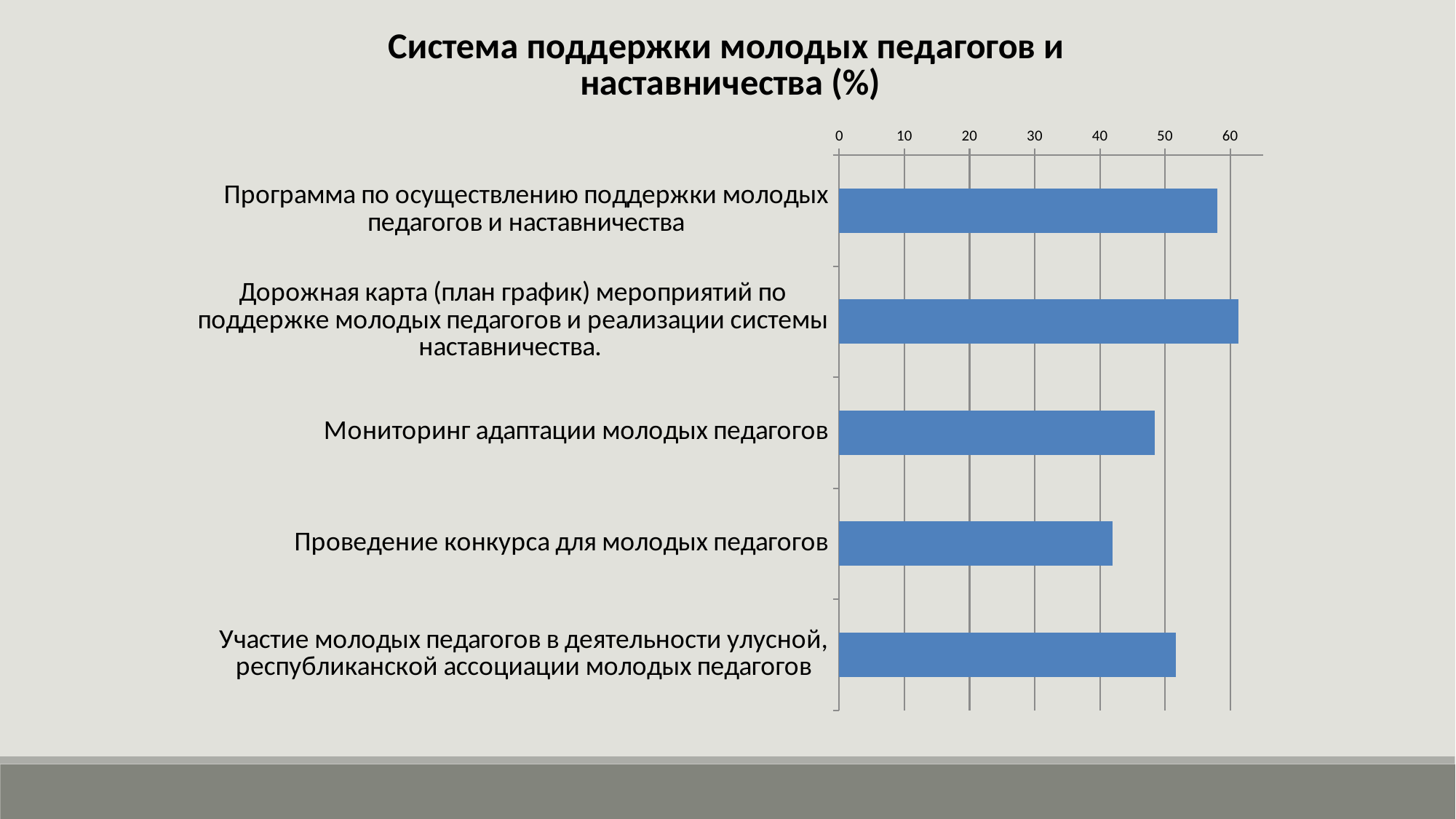
Is the value for "Программа по осуществлению поддержки молодых педагогов и наставничества" greater or less than 50? greater Is the value for "Мониторинг адаптации молодых педагогов" greater or less than 40? greater Is the value for "Проведение конкурса для молодых педагогов" greater or less than 50? less What kind of chart is shown on the slide? Bar chart What is the title of the chart? Система поддержки молодых педагогов и наставничества (%) Which category has the highest value in the chart? Дорожная карта (план график) мероприятий по поддержке молодых педагогов и реализации системы наставничества. Which category has the lowest value in the chart? Проведение конкурса для молодых педагогов Which is larger: the value for "Проведение конкурса для молодых педагогов" or for "Участие молодых педагогов в деятельности улусной, республиканской ассоциации молодых педагогов"? Участие молодых педагогов в деятельности улусной, республиканской ассоциации молодых педагогов How many categories are plotted in the chart? 5 What colour are the bars in the chart? Blue Which is larger: the value for "Программа по осуществлению поддержки молодых педагогов и наставничества" or for "Мониторинг адаптации молодых педагогов"? Программа по осуществлению поддержки молодых педагогов и наставничества